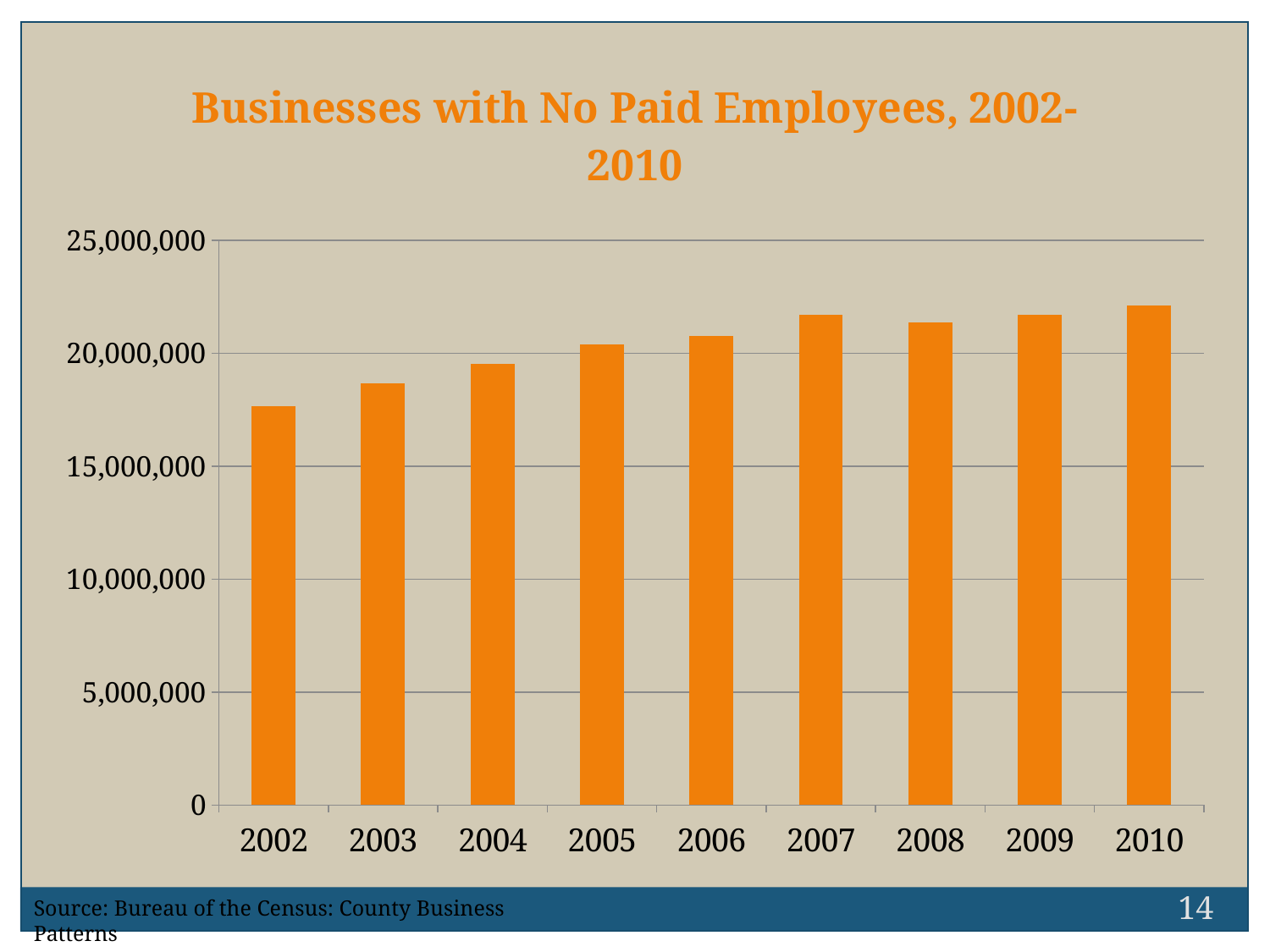
How many years are plotted on the x axis of the chart? 9 Do the values generally rise or fall from 2002 to 2010? rise Which year has the lowest number of businesses with no paid employees? 2002 Is the value for 2002 greater or less than 20,000,000? less Which year has a larger value, 2005 or 2008? 2008 Which year has the highest number of businesses with no paid employees? 2010 What is the title of the chart? Businesses with No Paid Employees, 2002-2010 Is the value for 2010 greater or less than 20,000,000? greater Is the value for 2004 greater or less than 20,000,000? less Which year has a larger value, 2003 or 2006? 2006 What kind of chart is shown on the slide? bar chart